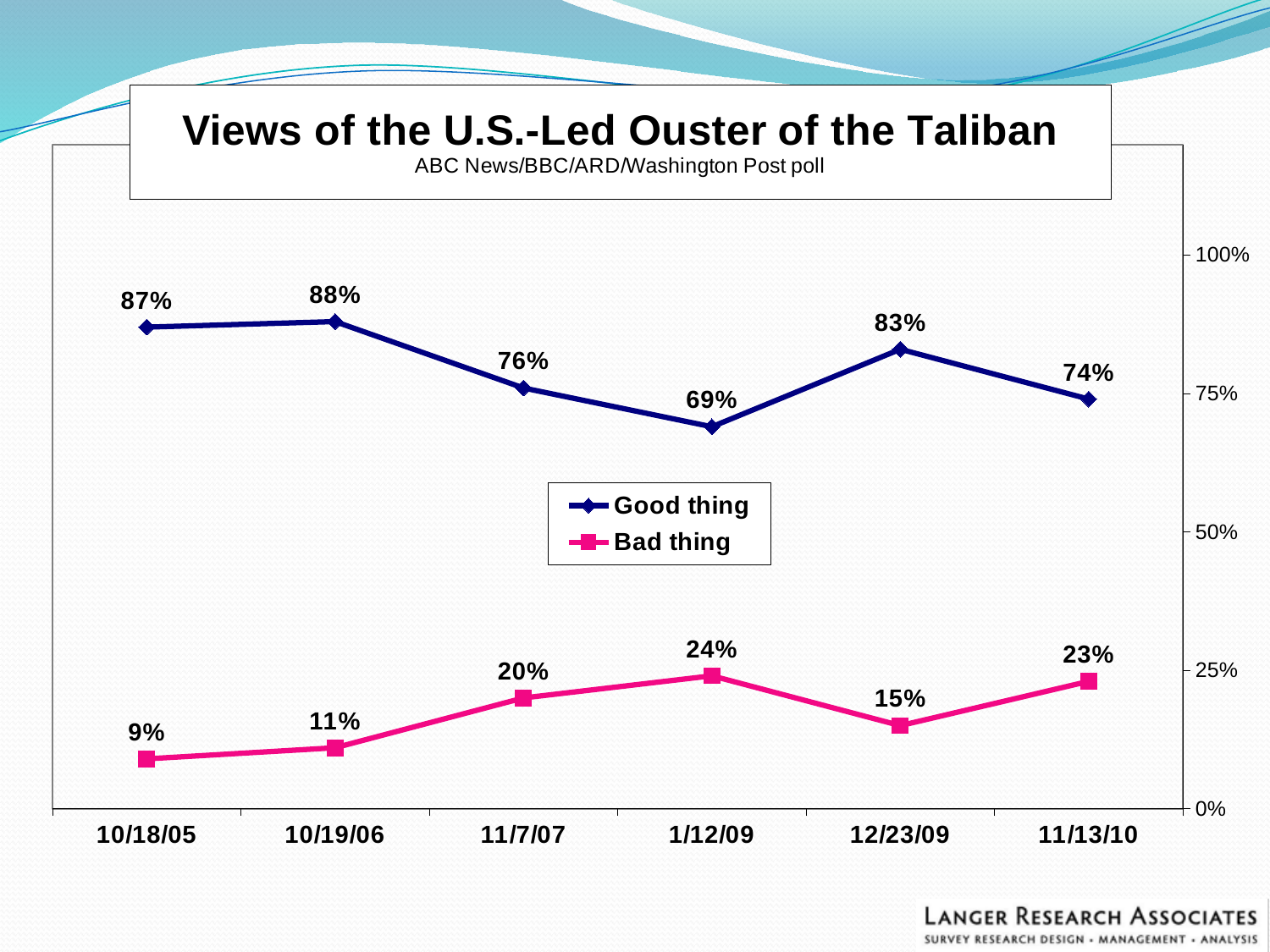
Which poll is cited in the chart's subtitle? ABC News/BBC/ARD/Washington Post poll What percentage said the ouster was a bad thing on 12/23/09? 15% On which date was the Good thing value lowest? 1/12/09 What kind of chart is shown on the slide? Line chart How many poll dates are shown on the x axis? 6 Is the Good thing value on 12/23/09 greater or less than 75%? greater On which date was the Bad thing value highest? 1/12/09 What is the value for Good thing on 11/13/10? 74% What is the difference between the Good thing and Bad thing values on 11/7/07? 56 percentage points Which is larger, the Bad thing value on 10/18/05 or on 11/13/10? 11/13/10 What percentage said the ouster of the Taliban was a good thing on 10/19/06? 88% How many series does the legend list? 2